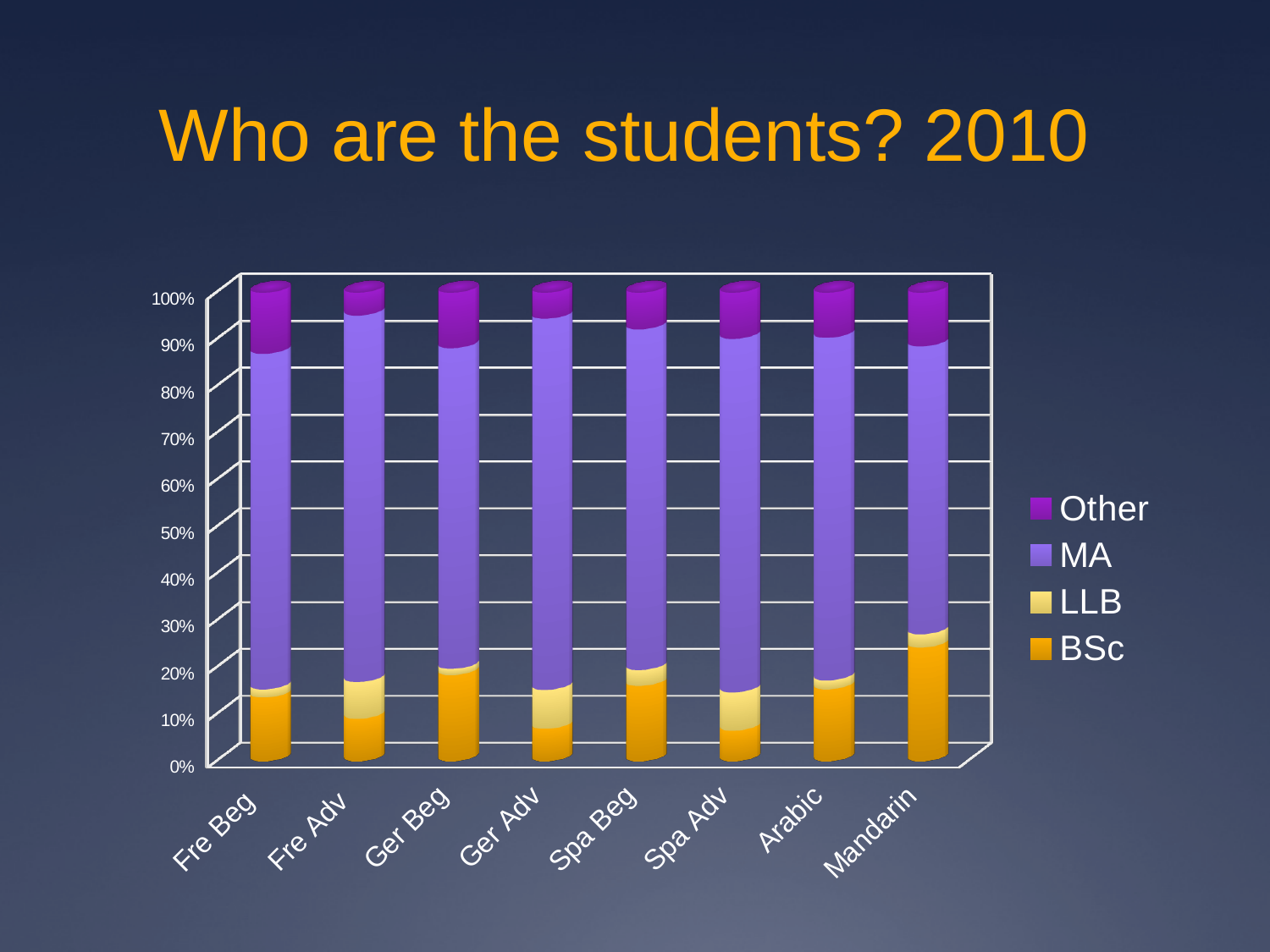
Is the BSc share for Ger Beg greater or less than 10%? greater Which is larger, the LLB share for Fre Adv or for Mandarin? Fre Adv Is the BSc share for Fre Adv greater or less than 20%? less Is the BSc share for Mandarin greater or less than 20%? greater Which series is shown in orange in the chart? BSc How many categories are shown along the x axis of the chart? 8 What kind of chart is shown on the slide? Stacked bar chart Which is larger, the BSc share for Mandarin or for Fre Adv? Mandarin What is the title of the slide containing the chart? Who are the students? 2010 Which is larger, the Other share for Mandarin or for Fre Adv? Mandarin Which category has the largest BSc share? Mandarin How many series does the chart's legend list? 4